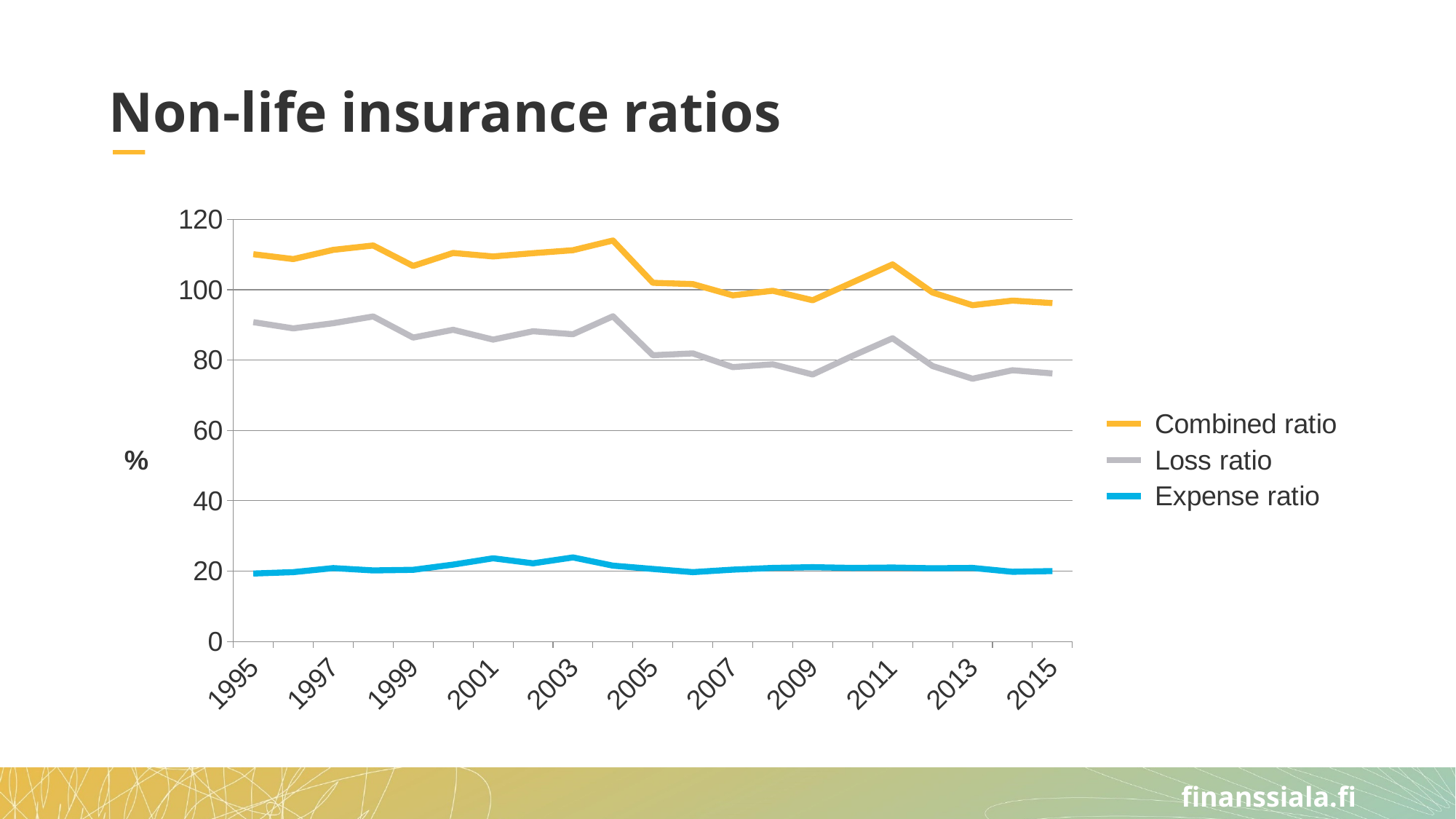
What is the title of the chart on the slide? Non-life insurance ratios In 2005, which is larger, the Combined ratio or the Loss ratio? Combined ratio Is the Loss ratio in 1995 greater or less than 80? greater Does the Combined ratio overall rise or fall from 1995 to 2015? fall Is the Expense ratio in 2001 greater or less than 20? greater Is the Combined ratio in 2013 greater or less than 100? less Which series is drawn in blue? Expense ratio Which series has the lowest values across all years? Expense ratio What kind of chart is shown on the slide? line chart How many series does the legend list? 3